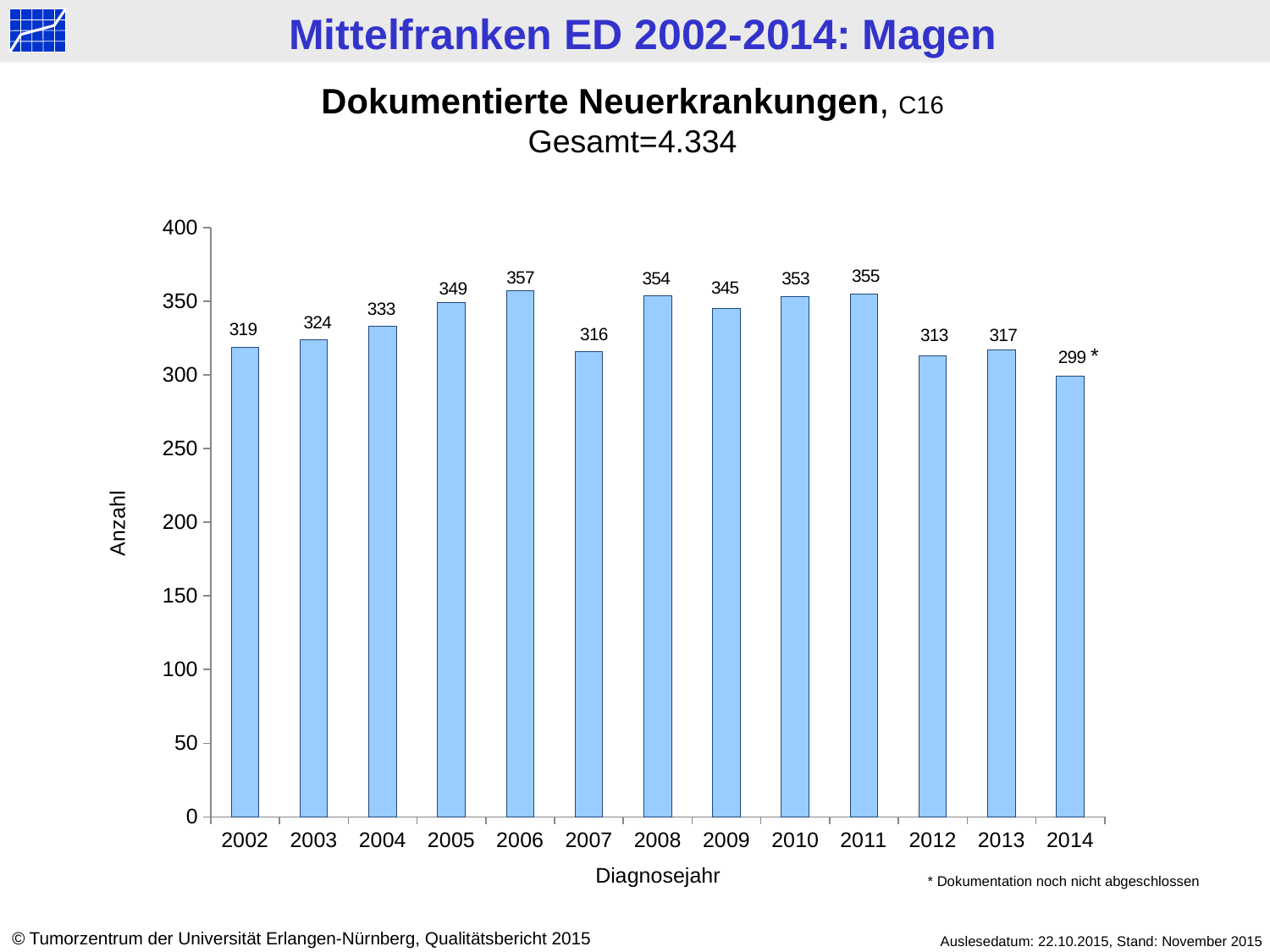
How many years are shown on the x axis? 13 What is the difference between the values for 2006 and 2007? 41 What kind of chart is shown? bar chart What is the value for 2012? 313 What is the label of the y axis? Anzahl Which year has the highest value? 2006 What is the value for 2006? 357 What is the value for 2002? 319 Which is larger, the value for 2008 or the value for 2009? 2008 Do the values rise or fall from 2011 to 2014? fall Which year has the lowest value? 2014 Is the value for 2014 greater or less than 300? less